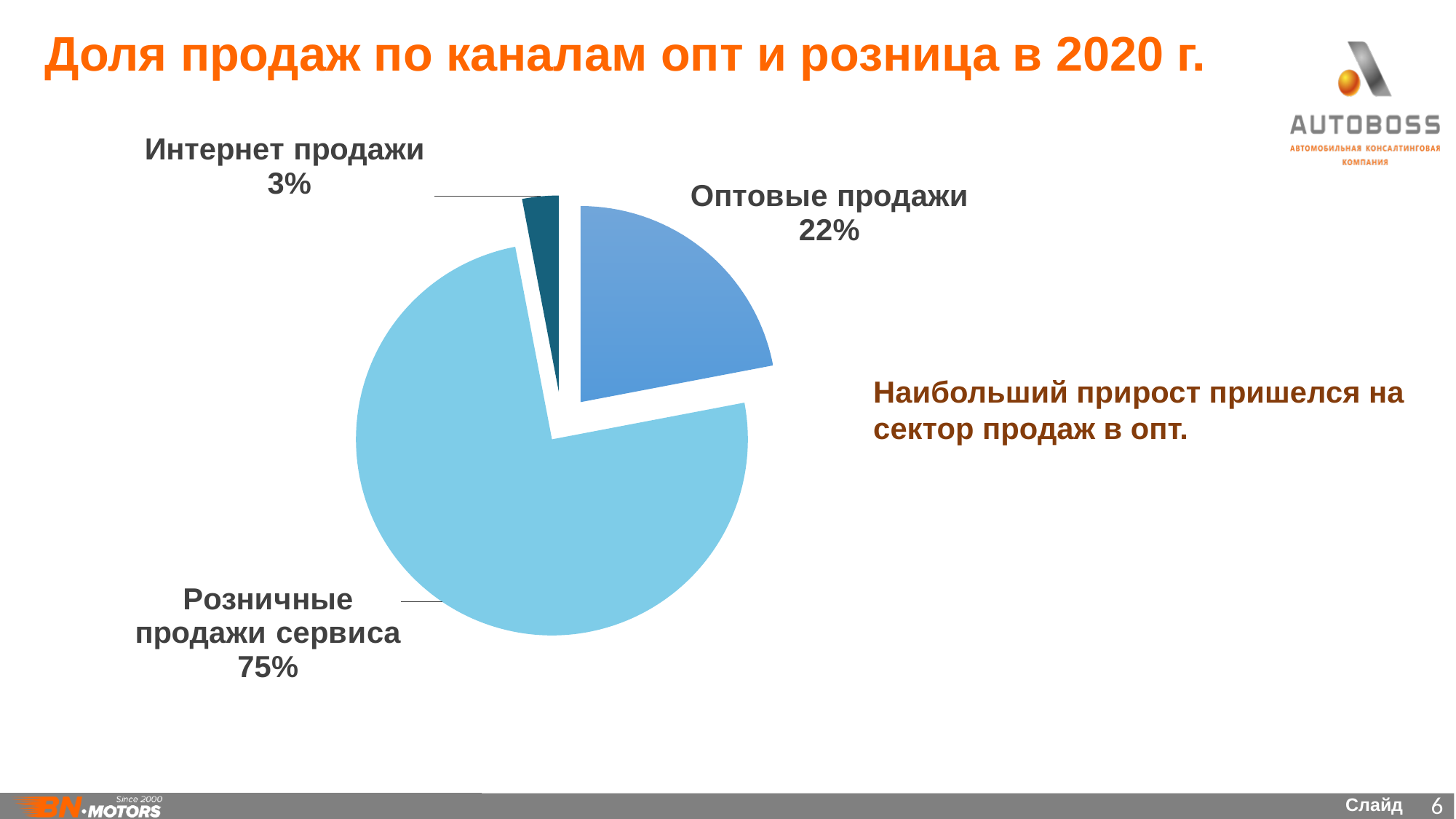
What type of chart is shown on the slide? Pie chart Which sales channel has the largest share of the pie? Розничные продажи сервиса Which slice of the pie is shown in the darkest colour? Интернет продажи Which sales channel has the smallest share of the pie? Интернет продажи What share of sales do Оптовые продажи account for? 22% What is the difference in percentage points between Оптовые продажи and Интернет продажи? 19 How many slices does the pie chart have? 3 What share of sales do Интернет продажи account for? 3% What share of sales do Розничные продажи сервиса account for? 75% Which is larger: the share of Оптовые продажи or the share of Интернет продажи? Оптовые продажи What is the title of the slide containing the chart? Доля продаж по каналам опт и розница в 2020 г. What is the difference in percentage points between Розничные продажи сервиса and Оптовые продажи? 53